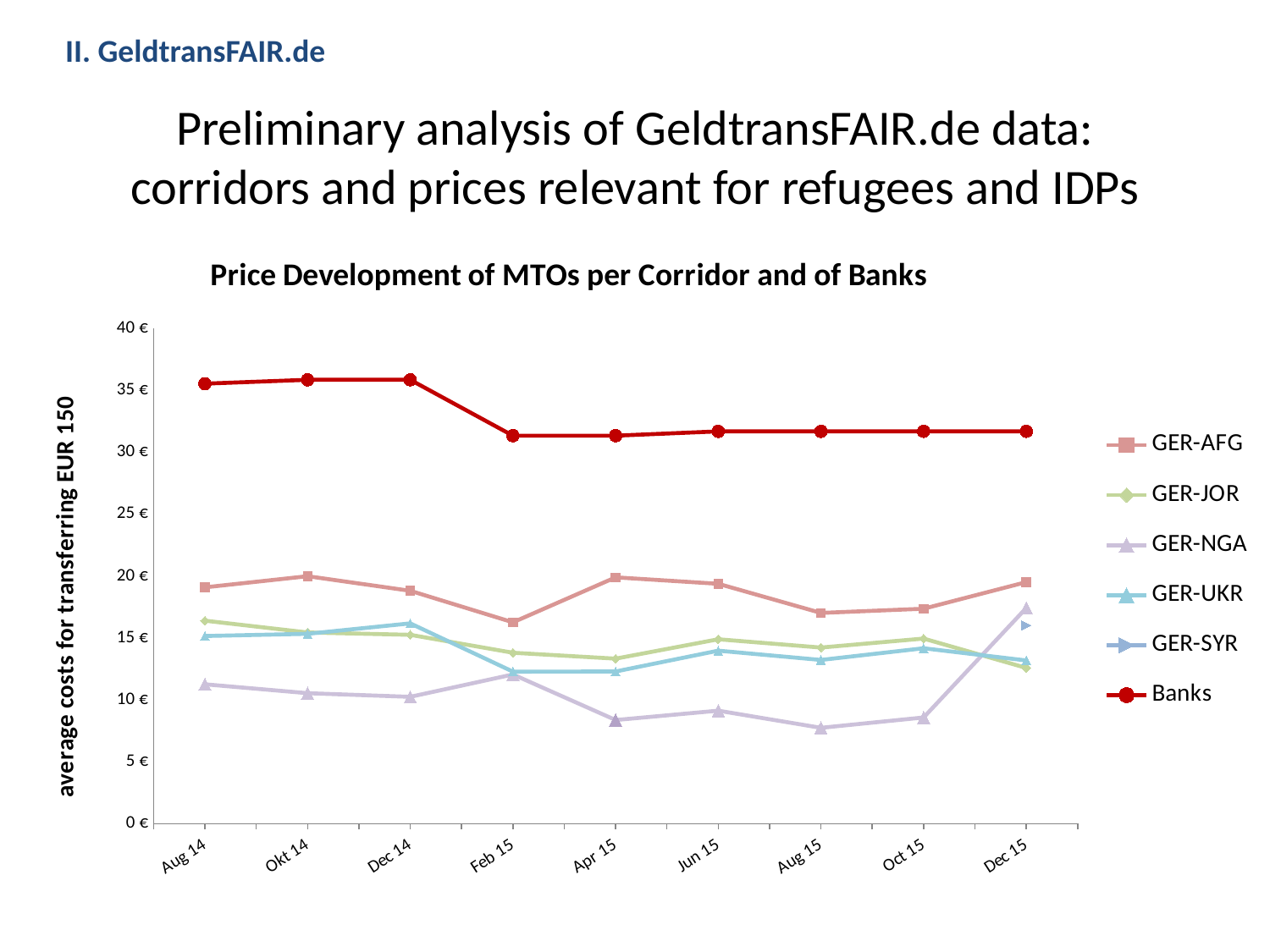
Is the value for GER-NGA in Aug 15 greater or less than 10 €? less Is the value for GER-JOR in Aug 14 greater or less than 15 €? greater How many series does the legend list? 6 Is the value for Banks in Feb 15 greater or less than 30 €? greater Which series has the lowest value in Aug 15? GER-NGA Do the values for Banks rise or fall from Aug 14 to Dec 15? fall How many time points are shown on the x axis? 9 Which series has the highest values across the whole period? Banks What is the title of the chart? Price Development of MTOs per Corridor and of Banks In Dec 15, which is larger: GER-NGA or GER-UKR? GER-NGA What kind of chart is shown on the slide? line chart